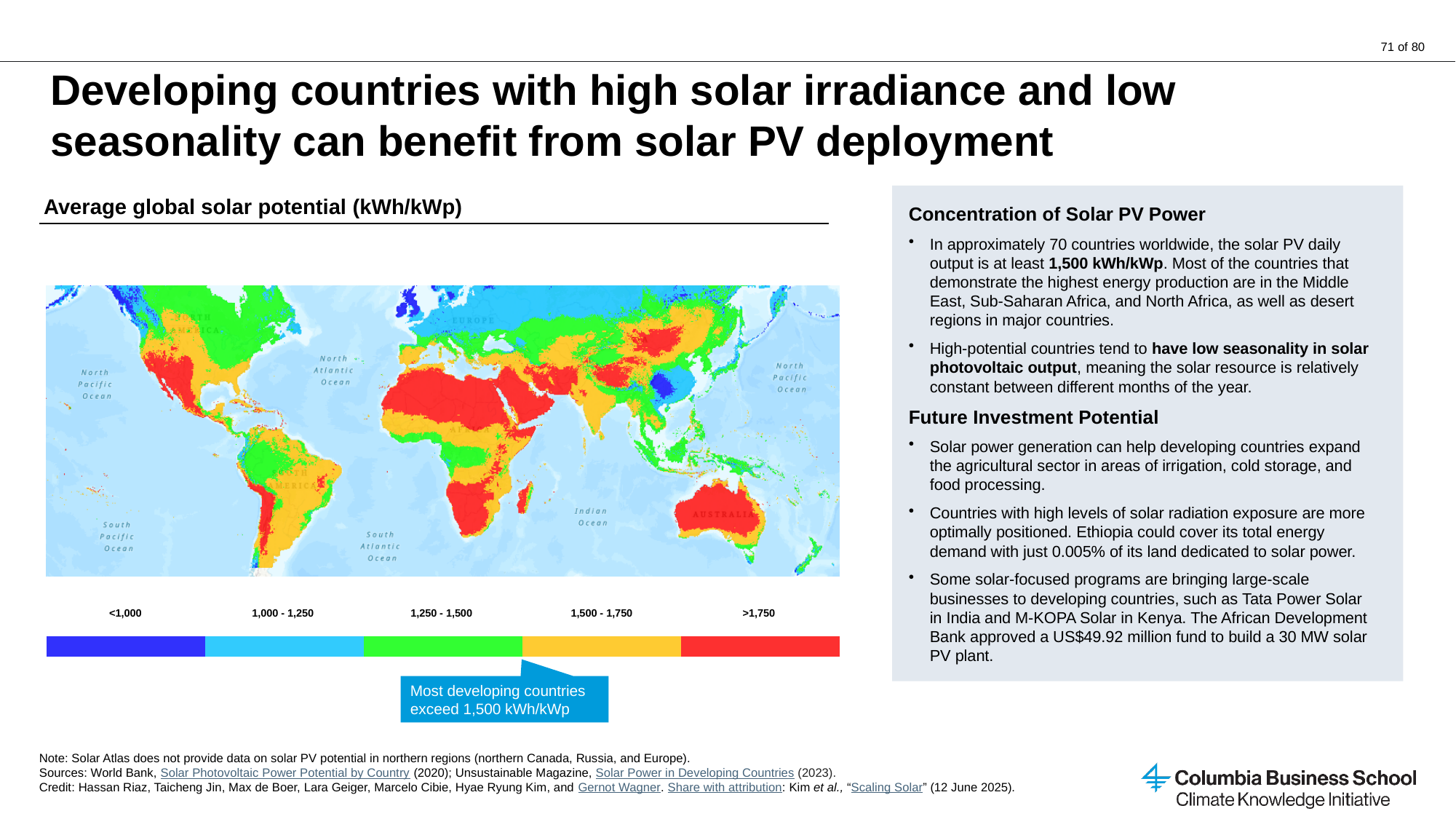
What is the lowest value range shown in the map legend? <1,000 Which value range does the red colour on the map represent? >1,750 What kind of chart is shown on the slide? A map What is the title of the chart? Average global solar potential (kWh/kWp) In what unit is solar potential measured on the map? kWh/kWp Which value range does the dark blue colour on the map represent? <1,000 How many value ranges does the map legend show? 5 According to the callout below the legend, what solar potential do most developing countries exceed? 1,500 kWh/kWp Which value range does the light blue colour on the map represent? 1,000 - 1,250 Which value range does the green colour on the map represent? 1,250 - 1,500 What is the highest value range shown in the map legend? >1,750 Which value range does the yellow colour on the map represent? 1,500 - 1,750